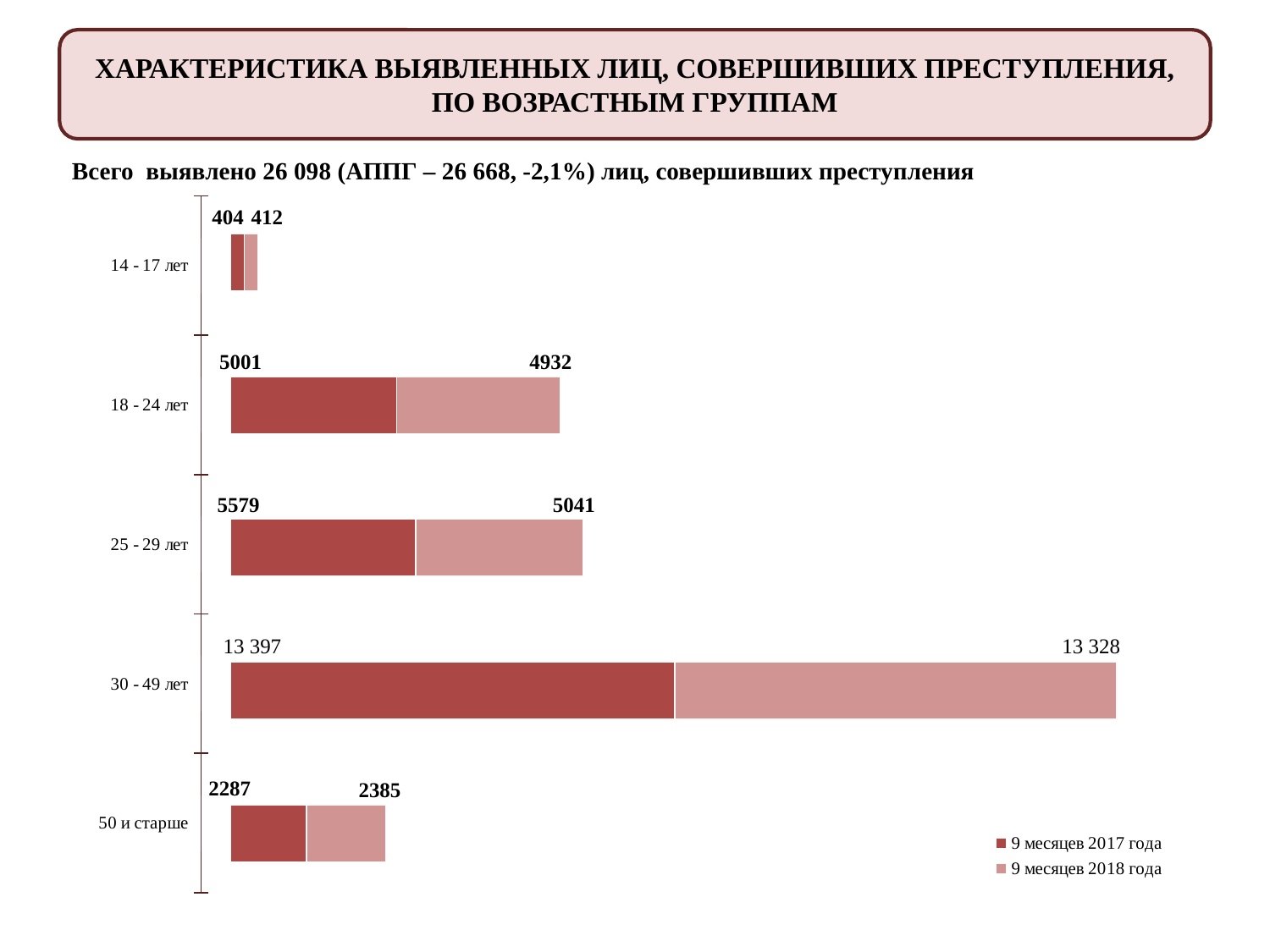
What kind of chart is shown on the slide? Stacked bar chart What is the difference between the 9 месяцев 2017 года and 9 месяцев 2018 года values for the 25 - 29 лет age group? 538 What is the total of the stacked bar for the 18 - 24 лет age group? 9933 What is the value for the 50 и старше age group in the 9 месяцев 2018 года series? 2385 What is the value for the 18 - 24 лет age group in the 9 месяцев 2018 года series? 4932 For the 50 и старше age group, which series has the larger value: 9 месяцев 2017 года or 9 месяцев 2018 года? 9 месяцев 2018 года Which age group has the lowest value in the 9 месяцев 2017 года series? 14 - 17 лет How many series does the legend list? 2 Which age group has the highest value in the 9 месяцев 2018 года series? 30 - 49 лет What is the value for the 30 - 49 лет age group in the 9 месяцев 2017 года series? 13 397 What is the value for the 14 - 17 лет age group in the 9 месяцев 2017 года series? 404 How many age groups are shown on the chart? 5